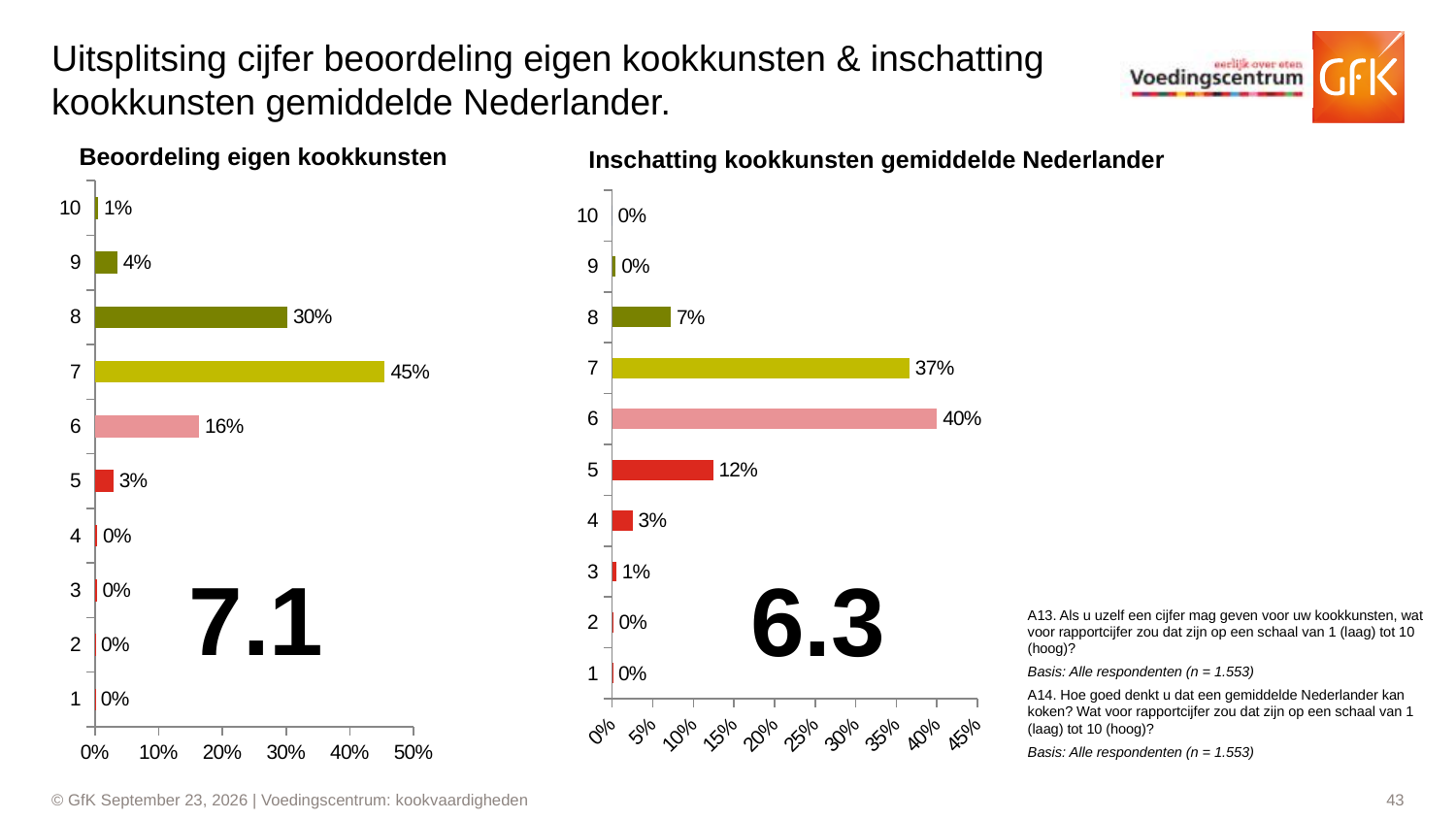
In the 'Inschatting kookkunsten gemiddelde Nederlander' chart, what percentage is shown for grade 6? 40% How many grade categories are shown in the 'Beoordeling eigen kookkunsten' chart? 10 In the 'Beoordeling eigen kookkunsten' chart, is the value for grade 8 greater or less than 20%? greater What large number is printed inside the 'Inschatting kookkunsten gemiddelde Nederlander' chart? 6.3 In the 'Beoordeling eigen kookkunsten' chart, what is the difference between the percentages for grade 7 and grade 8? 15% What kind of chart is the 'Inschatting kookkunsten gemiddelde Nederlander' chart? bar chart In the 'Inschatting kookkunsten gemiddelde Nederlander' chart, which is larger: the percentage for grade 7 or grade 8? 7 In the 'Beoordeling eigen kookkunsten' chart, what percentage is shown for grade 7? 45% In the 'Beoordeling eigen kookkunsten' chart, which grade has the highest percentage? 7 In the 'Inschatting kookkunsten gemiddelde Nederlander' chart, which grade has the highest percentage? 6 What large number is printed inside the 'Beoordeling eigen kookkunsten' chart? 7.1 In the 'Inschatting kookkunsten gemiddelde Nederlander' chart, what is the difference between the percentages for grade 6 and grade 5? 28%